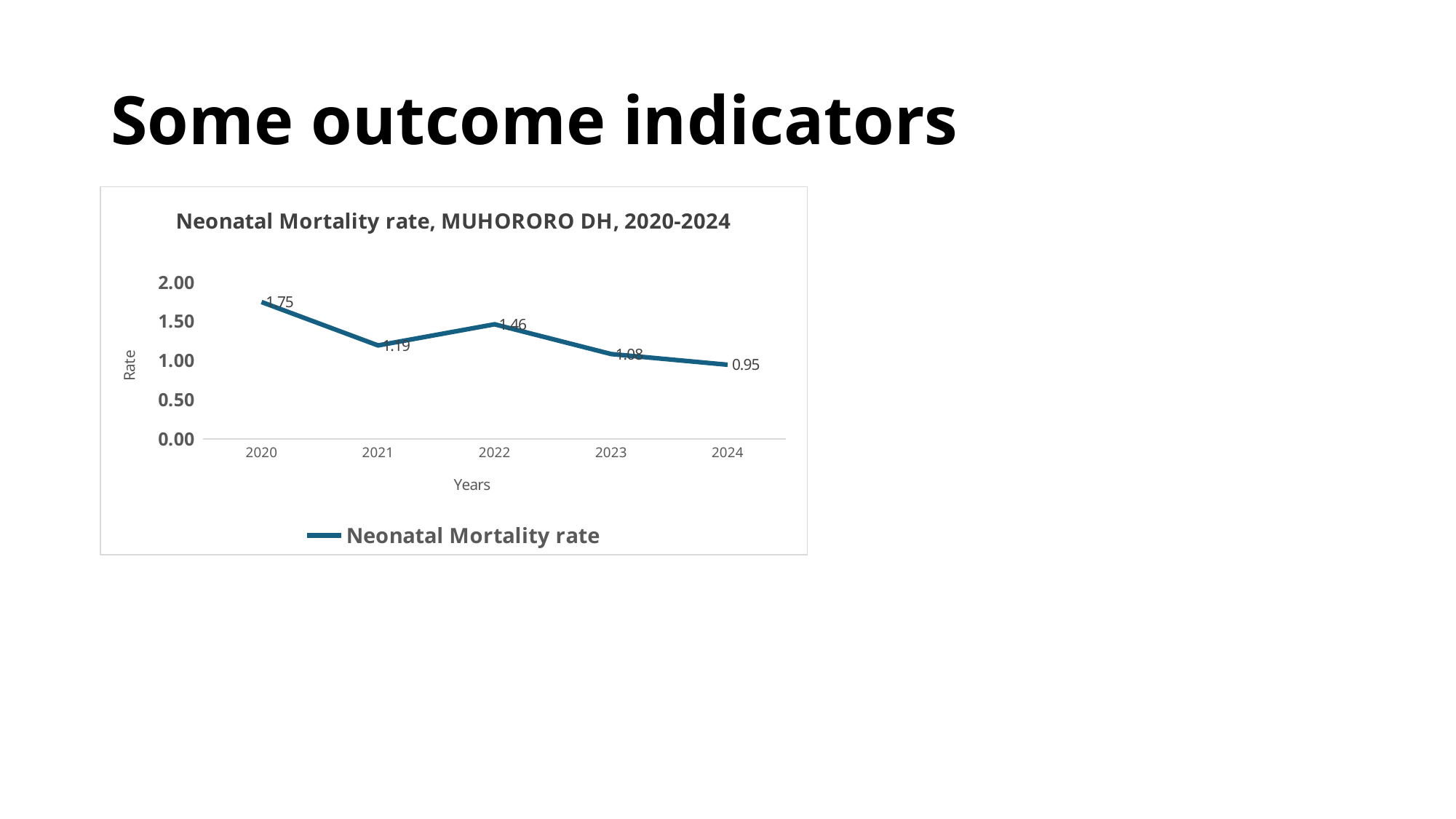
How many series does the legend list? 1 Which year has a higher neonatal mortality rate, 2021 or 2022? 2022 What is the neonatal mortality rate for 2024? 0.95 How many years are plotted on the chart? 5 What is the difference between the neonatal mortality rate in 2020 and in 2024? 0.80 Is the neonatal mortality rate for 2023 greater or less than 1.50? less What is the neonatal mortality rate for 2022? 1.46 Which year has the lowest neonatal mortality rate? 2024 Which year has the highest neonatal mortality rate? 2020 What is the title of the chart? Neonatal Mortality rate, MUHORORO DH, 2020-2024 What kind of chart is shown on the slide? line chart What is the neonatal mortality rate for 2020? 1.75